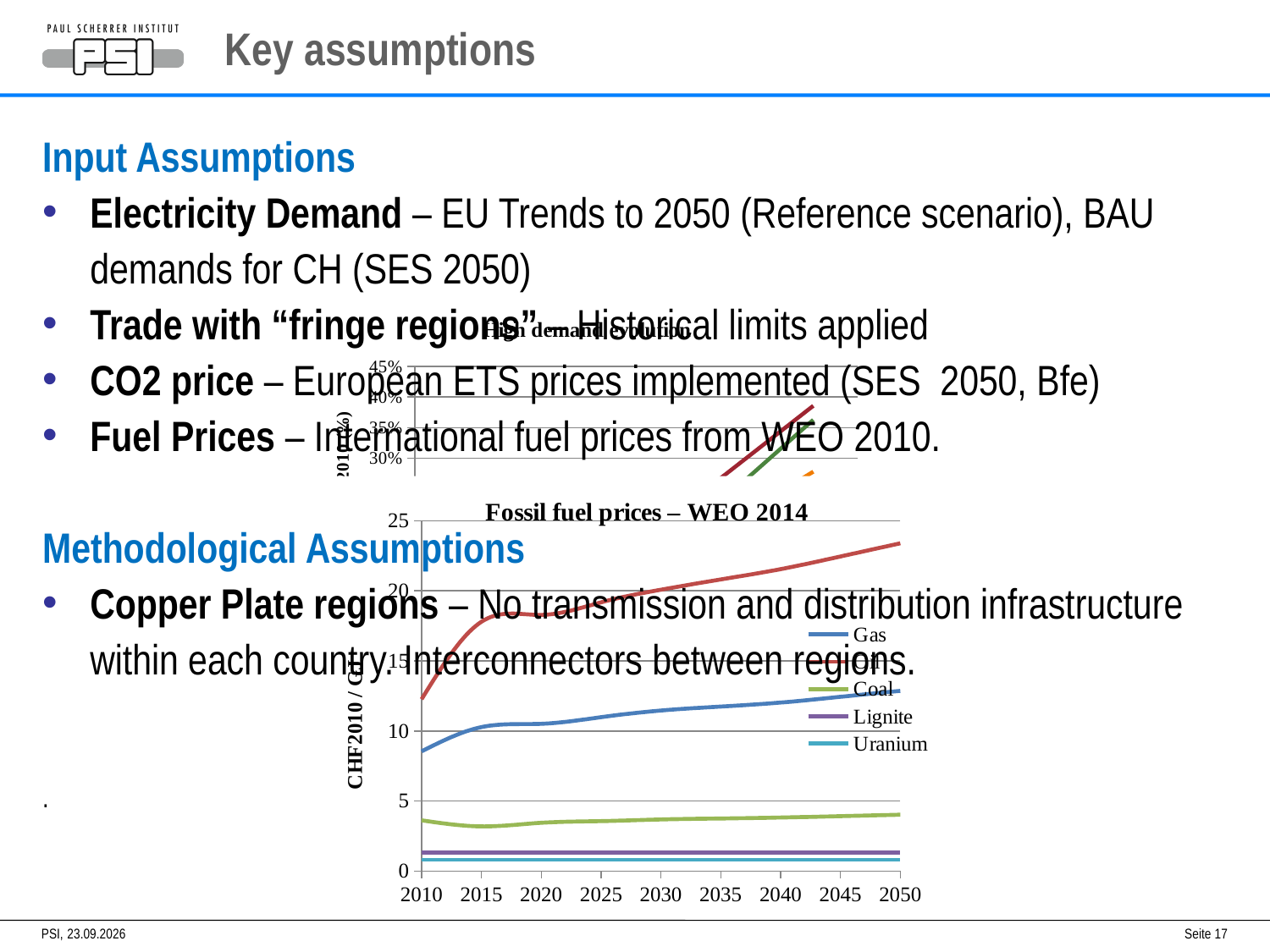
How many series does the legend of the 'Fossil fuel prices – WEO 2014' chart list? 5 In the 'Fossil fuel prices – WEO 2014' chart, is the value for Gas in 2010 greater or less than 10? less How many year labels are shown on the x axis of the 'Fossil fuel prices – WEO 2014' chart? 9 In the 'Fossil fuel prices – WEO 2014' chart, which series is drawn in red? Oil What kind of chart is the 'Fossil fuel prices – WEO 2014' chart? line chart In the 'Fossil fuel prices – WEO 2014' chart, which is larger in 2030, the Gas price or the Coal price? Gas What is the y-axis label of the 'Fossil fuel prices – WEO 2014' chart? CHF2010 / GJ In the 'Fossil fuel prices – WEO 2014' chart, is the value for Coal in 2050 greater or less than 5? less In the 'Fossil fuel prices – WEO 2014' chart, is the value for Oil in 2050 greater or less than 20? greater In the 'Fossil fuel prices – WEO 2014' chart, does the Oil price rise or fall from 2010 to 2050? rise In the 'Fossil fuel prices – WEO 2014' chart, which fuel has the lowest price across the whole period? Uranium In the 'Fossil fuel prices – WEO 2014' chart, which fuel has the highest price in 2050? Oil